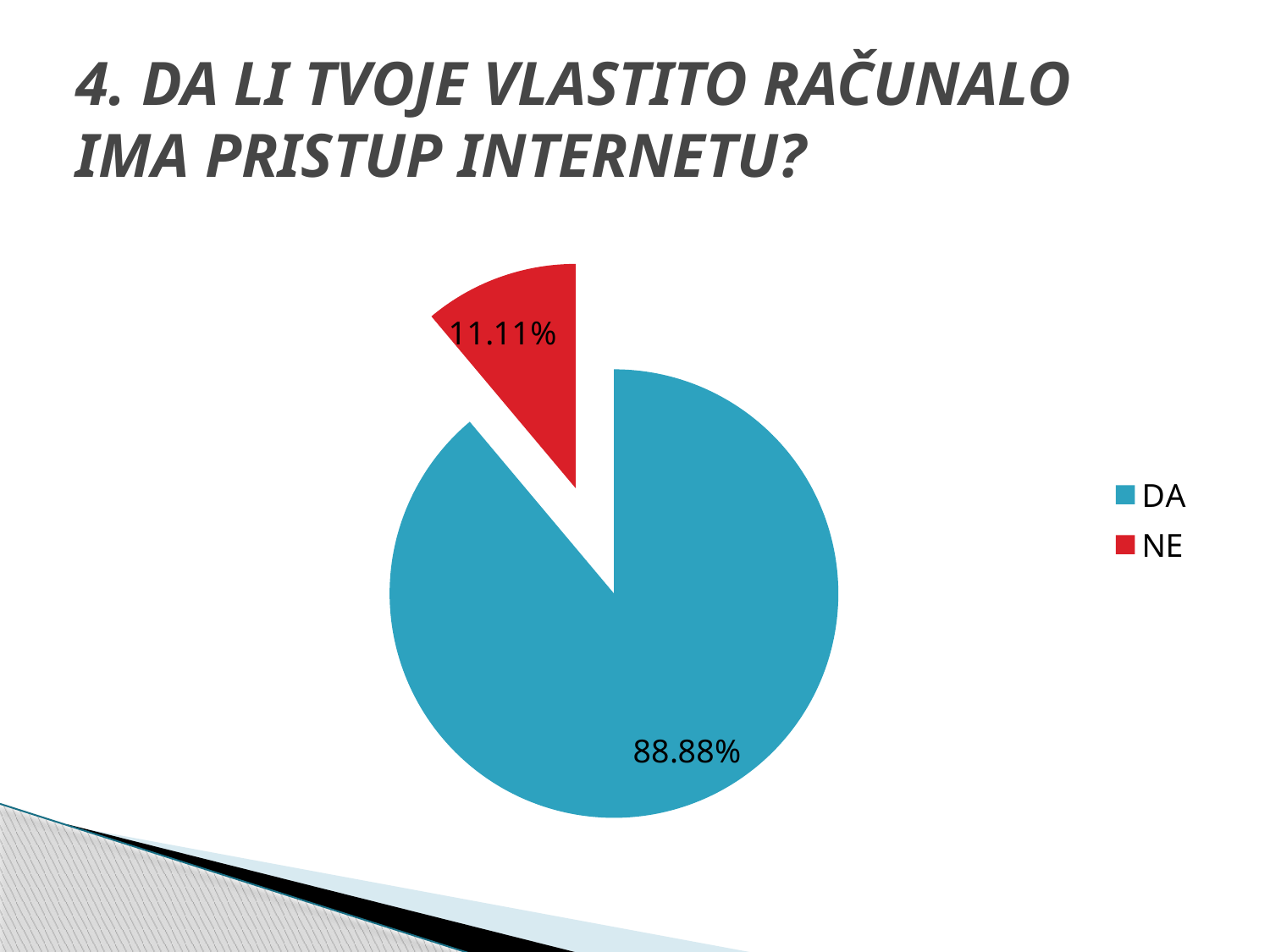
What type of chart is shown on the slide? pie chart Which slice of the pie is the largest? DA What colour is the DA slice? blue How many entries does the legend list? 2 What percentage of the pie is labelled for NE? 11.11% What colour is the NE slice? red What is the difference in percentage points between the DA slice and the NE slice? 77.77 What percentage of the pie is labelled for DA? 88.88% Which slice of the pie is the smallest? NE Which is larger, the DA slice or the NE slice? DA What share of the pie does the NE slice represent? 11.11% How many slices does the pie chart have? 2